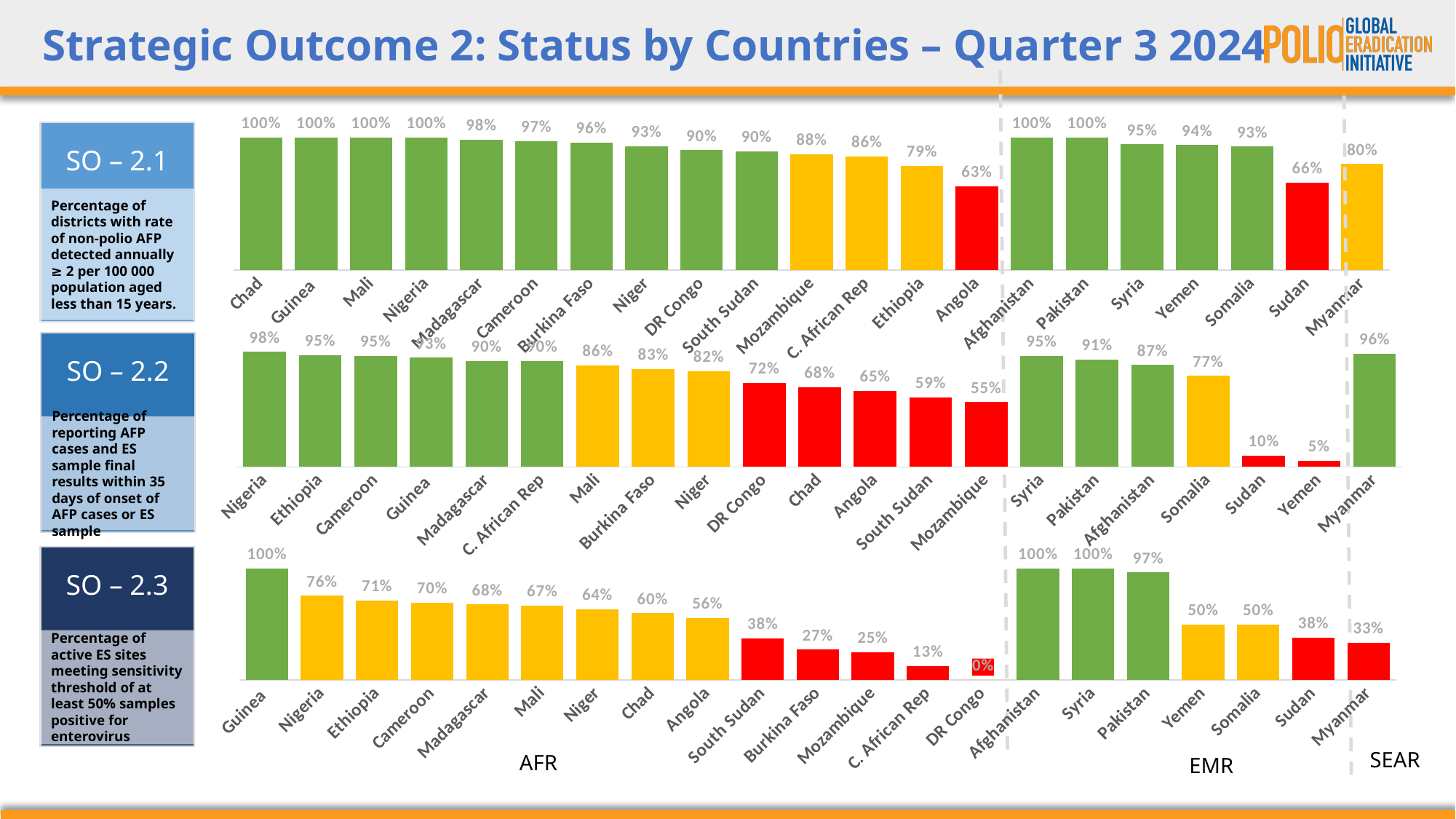
In the SO – 2.2 chart, which country has the lowest value? Yemen In the SO – 2.3 chart, what is the value for Yemen? 50% In the SO – 2.3 chart, what is the difference between Pakistan and Myanmar? 64% In the SO – 2.1 chart, how many countries are shown in the EMR group? 6 In the SO – 2.2 chart, what colour is the bar for Sudan? Red In the SO – 2.2 chart, what is the value for Mozambique? 55% In the SO – 2.2 chart, what is the difference between Nigeria and DR Congo? 26% What kind of chart is used for SO – 2.1? Bar chart In the SO – 2.3 chart, what is the value for DR Congo? 0% In the SO – 2.3 chart, which is larger, the value for Nigeria or the value for Chad? Nigeria In the SO – 2.1 chart, what is the value for Sudan? 66% In the SO – 2.1 chart, what is the value for Angola? 63%